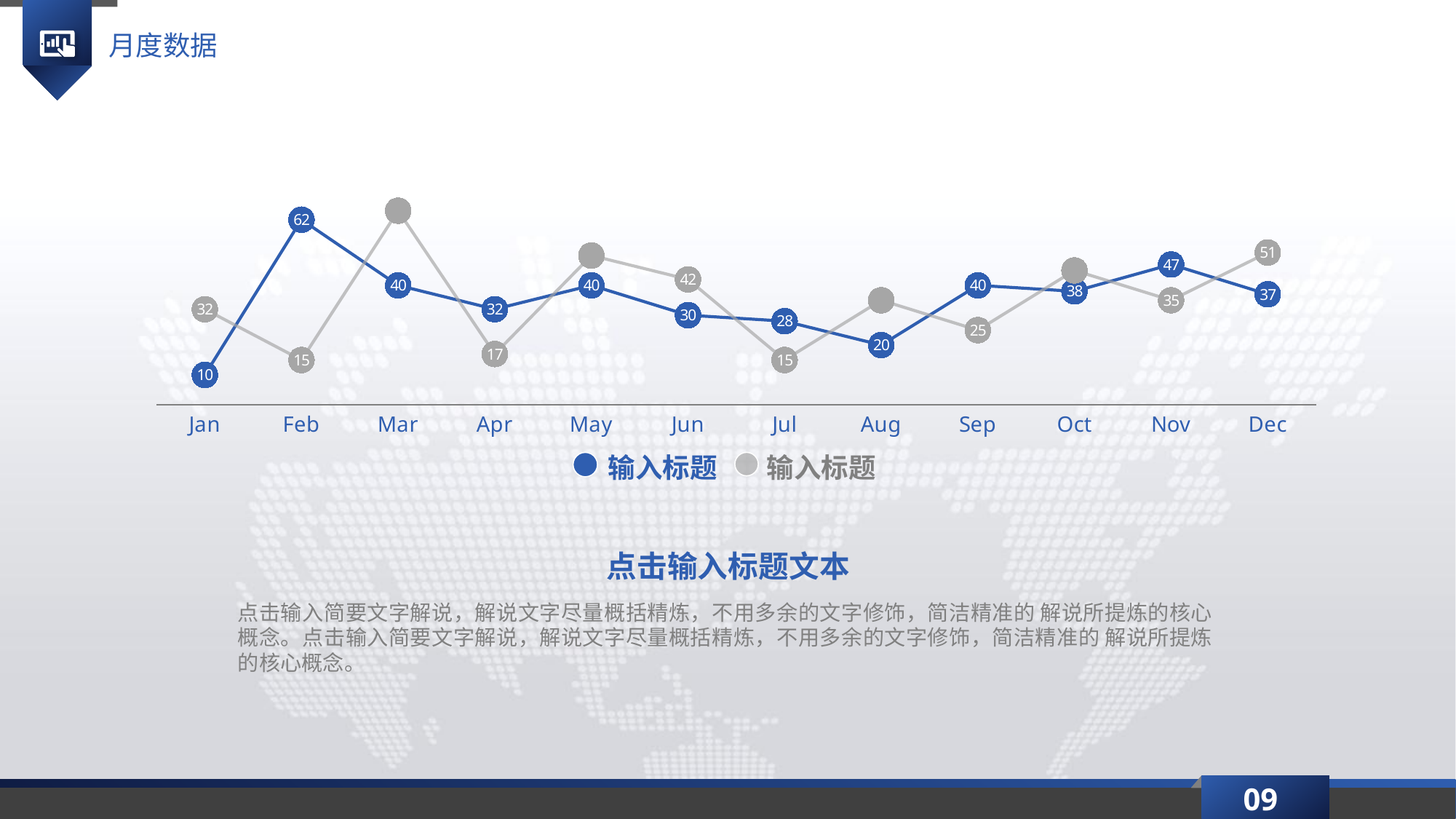
How many series does the legend list? 2 How many months are plotted along the x axis? 12 What type of chart is shown on the slide? line chart In which month does the blue series have its lowest value? Jan Does the blue series rise or fall from Jun to Aug? fall What is the value of the blue series in Aug? 20 In Jun, which series has the larger value, blue or grey? grey What is the difference between the blue series values in Feb and Jan? 52 What is the value of the grey series in Dec? 51 In which month does the blue series reach its highest value? Feb What is the value of the blue series in Feb? 62 In which month does the grey series reach its highest point? Mar